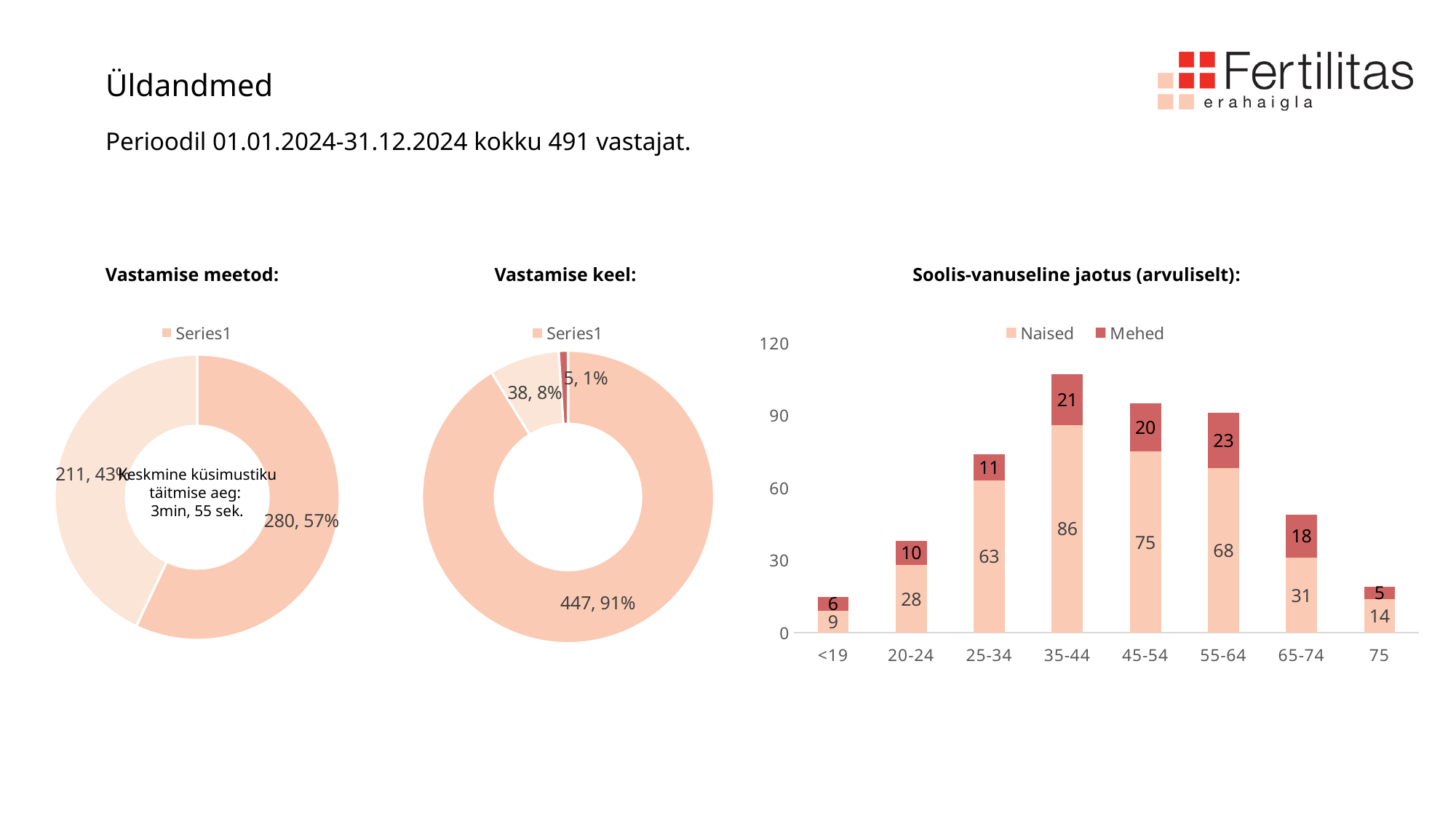
In the 'Soolis-vanuseline jaotus (arvuliselt):' chart, what is the Naised value for the 35-44 age group? 86 In the 'Vastamise keel:' chart, what share of the total does the largest slice represent? 91% In the 'Soolis-vanuseline jaotus (arvuliselt):' chart, which age group has the highest Naised value? 35-44 How many age groups are shown on the x axis of the 'Soolis-vanuseline jaotus (arvuliselt):' chart? 8 In the 'Soolis-vanuseline jaotus (arvuliselt):' chart, which age group has the lowest Mehed value? 75 In the 'Soolis-vanuseline jaotus (arvuliselt):' chart, what is the difference between the Naised values for 25-34 and 65-74? 32 In the 'Vastamise meetod:' chart, what is the value of the larger slice? 280 In the 'Soolis-vanuseline jaotus (arvuliselt):' chart, what is the Mehed value for the 55-64 age group? 23 In the 'Soolis-vanuseline jaotus (arvuliselt):' chart, which is larger: the Mehed value for 20-24 or for 65-74? 65-74 In the 'Soolis-vanuseline jaotus (arvuliselt):' chart, what is the total of the stacked bar for the 45-54 age group? 95 How many series does the legend of the 'Soolis-vanuseline jaotus (arvuliselt):' chart list? 2 What kind of chart is 'Vastamise keel:'? Doughnut chart